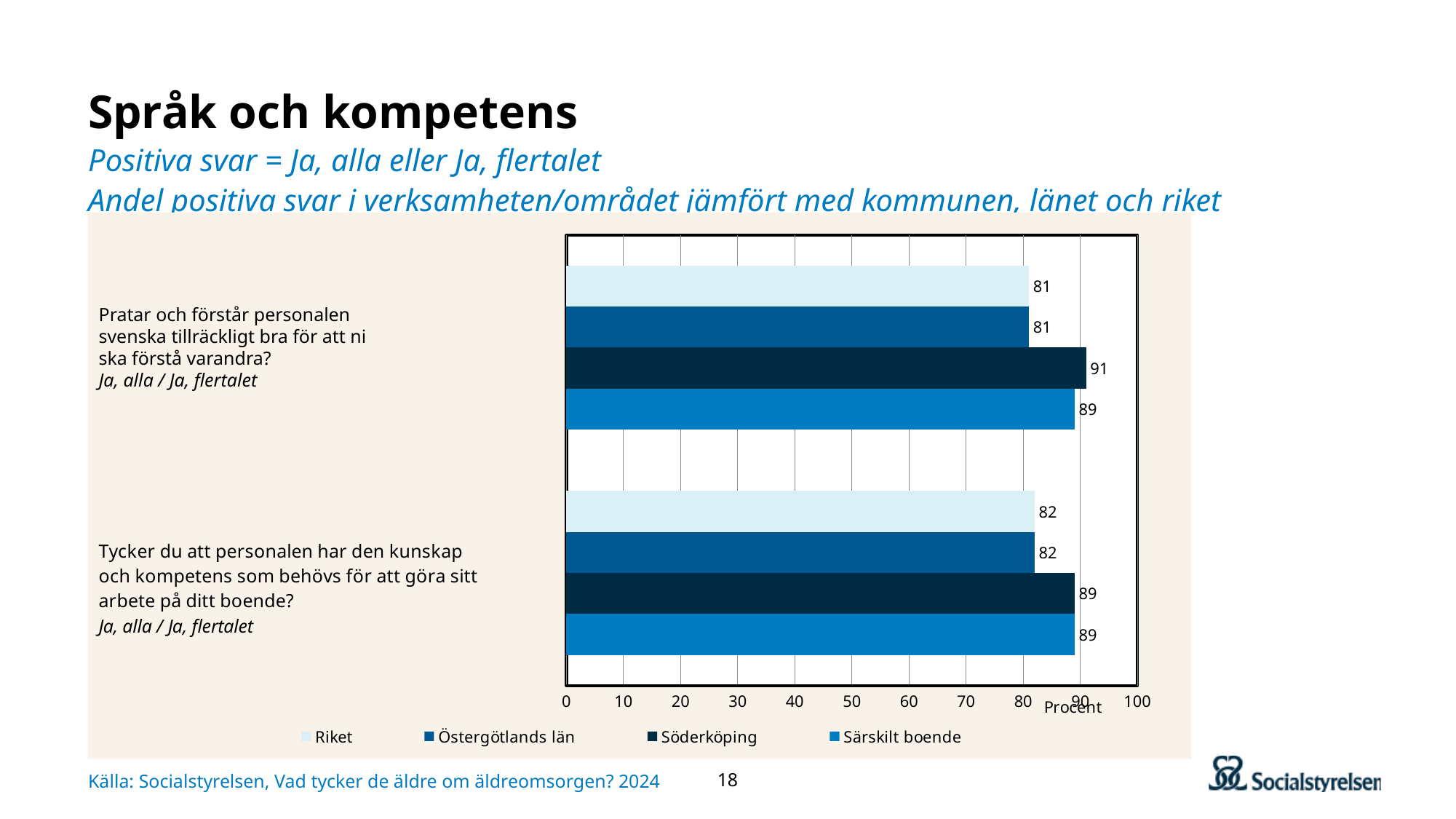
What is the difference between Särskilt boende and Östergötlands län on the question "Tycker du att personalen har den kunskap och kompetens som behövs för att göra sitt arbete på ditt boende?"? 7 What is the value for Särskilt boende on the question "Pratar och förstår personalen svenska tillräckligt bra för att ni ska förstå varandra?"? 89 What is the value for Riket on the question "Tycker du att personalen har den kunskap och kompetens som behövs för att göra sitt arbete på ditt boende?"? 82 Is the value for Riket on the question "Pratar och förstår personalen svenska tillräckligt bra för att ni ska förstå varandra?" greater or less than 90? less What is the difference between Söderköping and Riket on the question "Pratar och förstår personalen svenska tillräckligt bra för att ni ska förstå varandra?"? 10 Which series has the highest value on the question "Pratar och förstår personalen svenska tillräckligt bra för att ni ska förstå varandra?"? Söderköping What is the label of the horizontal axis? Procent What kind of chart is shown on the slide? Bar chart How many series does the legend list? 4 What is the value for Söderköping on the question "Pratar och förstår personalen svenska tillräckligt bra för att ni ska förstå varandra?"? 91 Which is larger on the question "Pratar och förstår personalen svenska tillräckligt bra för att ni ska förstå varandra?": Söderköping or Särskilt boende? Söderköping What is the value for Östergötlands län on the question "Tycker du att personalen har den kunskap och kompetens som behövs för att göra sitt arbete på ditt boende?"? 82